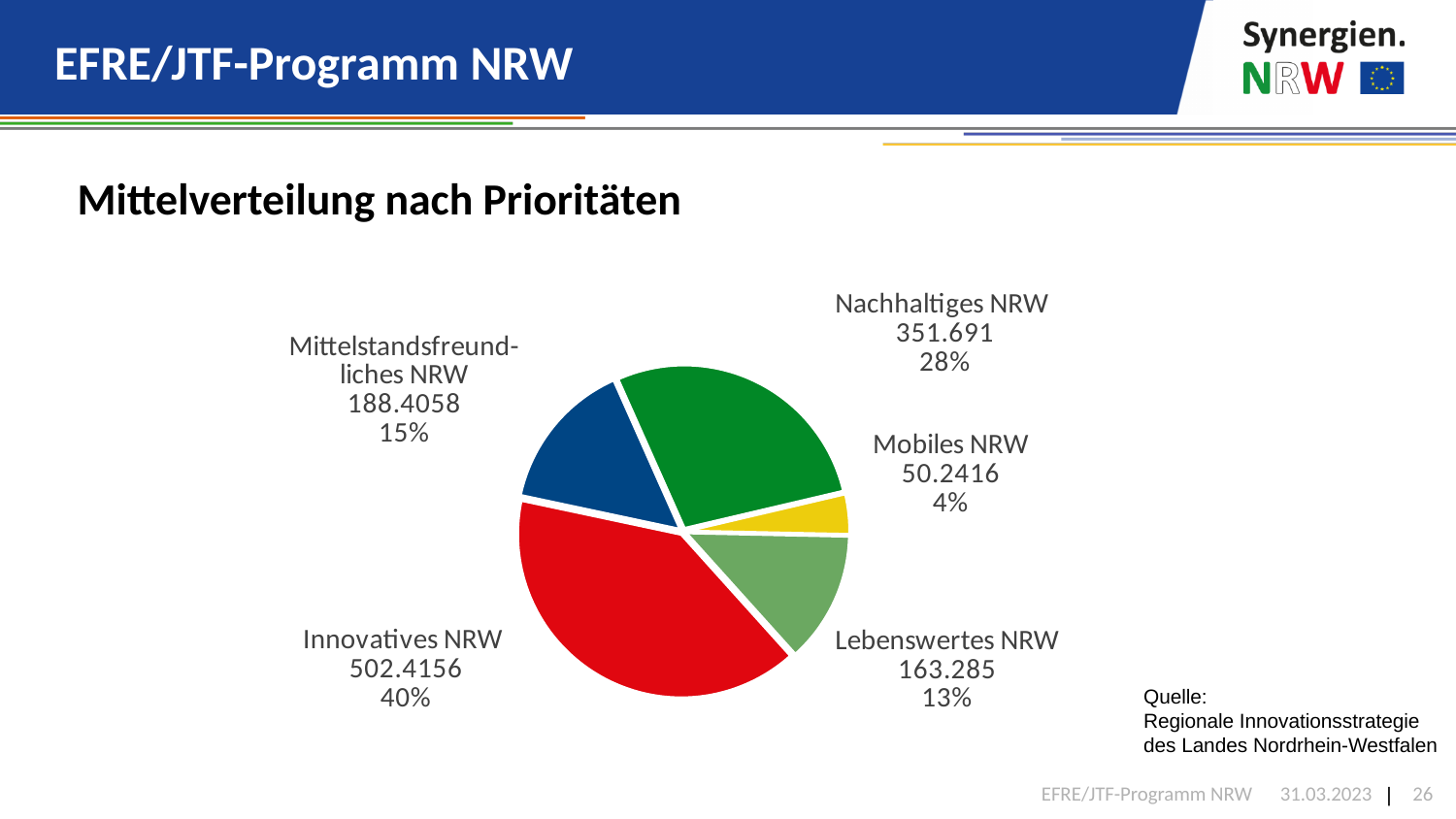
Which is larger, Nachhaltiges NRW or Lebenswertes NRW? Nachhaltiges NRW What percentage share does Mittelstandsfreundliches NRW have? 15% Which category has the smallest slice? Mobiles NRW What kind of chart is shown on the slide? pie chart What is the title of the chart? Mittelverteilung nach Prioritäten What is the value shown for Innovatives NRW? 502.4156 What percentage share does Innovatives NRW have? 40% What is the value shown for Nachhaltiges NRW? 351.691 What is the value shown for Mobiles NRW? 50.2416 Which category has the largest slice? Innovatives NRW How many categories are shown in the pie chart? 5 What is the value shown for Lebenswertes NRW? 163.285